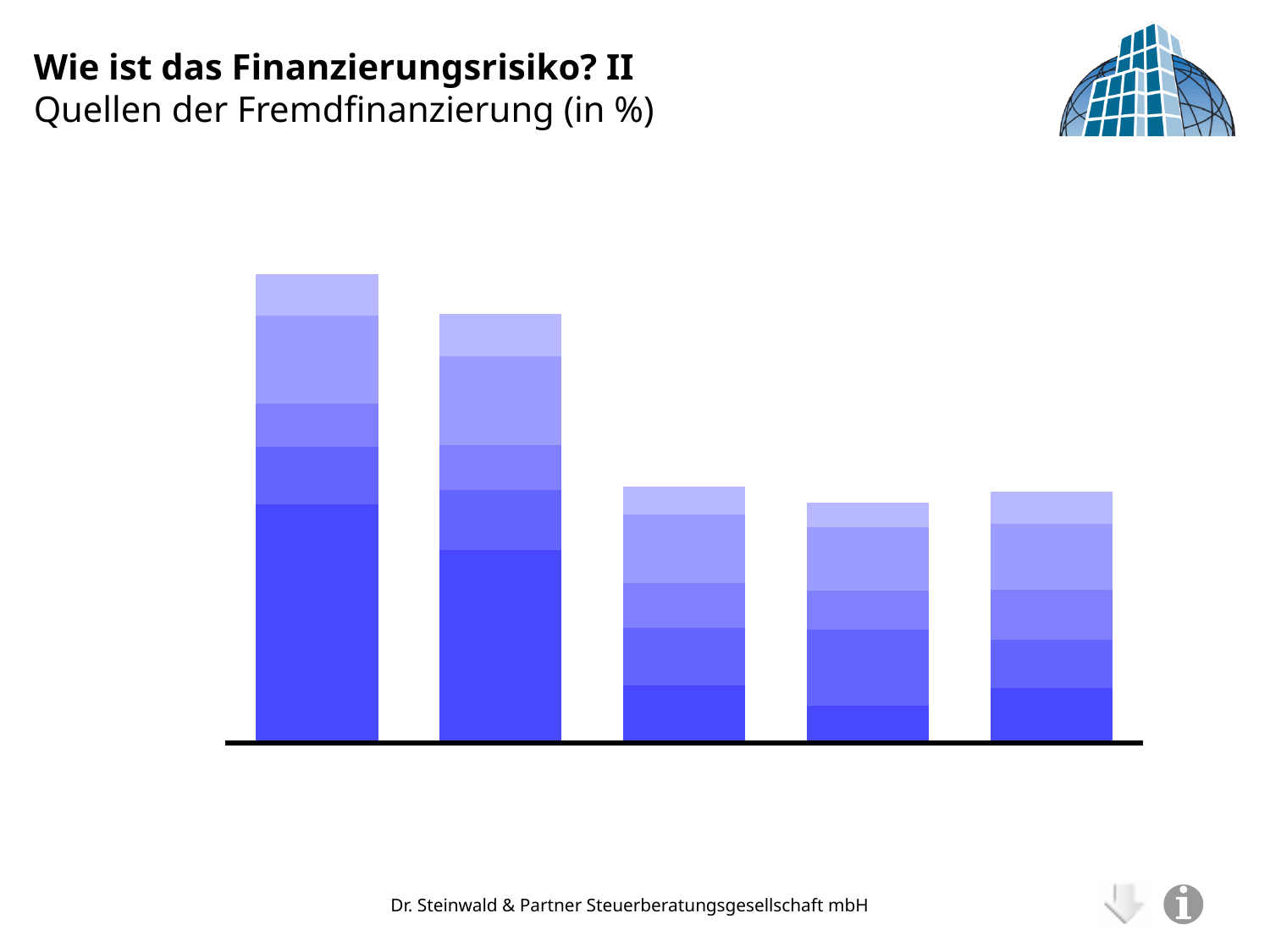
Which bar has the largest bottom (darkest blue) segment? the leftmost (first) bar What is the subtitle of the chart on the slide? Quellen der Fremdfinanzierung (in %) Is the first bar taller or shorter than the fourth bar? taller Do the bar heights generally rise or fall from left to right? fall How many stacked segments does each bar have? 5 Which bar is the tallest in the chart? the leftmost (first) bar What kind of chart is shown on the slide? stacked bar chart How many bars does the chart contain? 5 Is the first (leftmost) bar taller or shorter than the second bar? taller What colour family are the bar segments drawn in? shades of blue Is the second bar taller or shorter than the third bar? taller